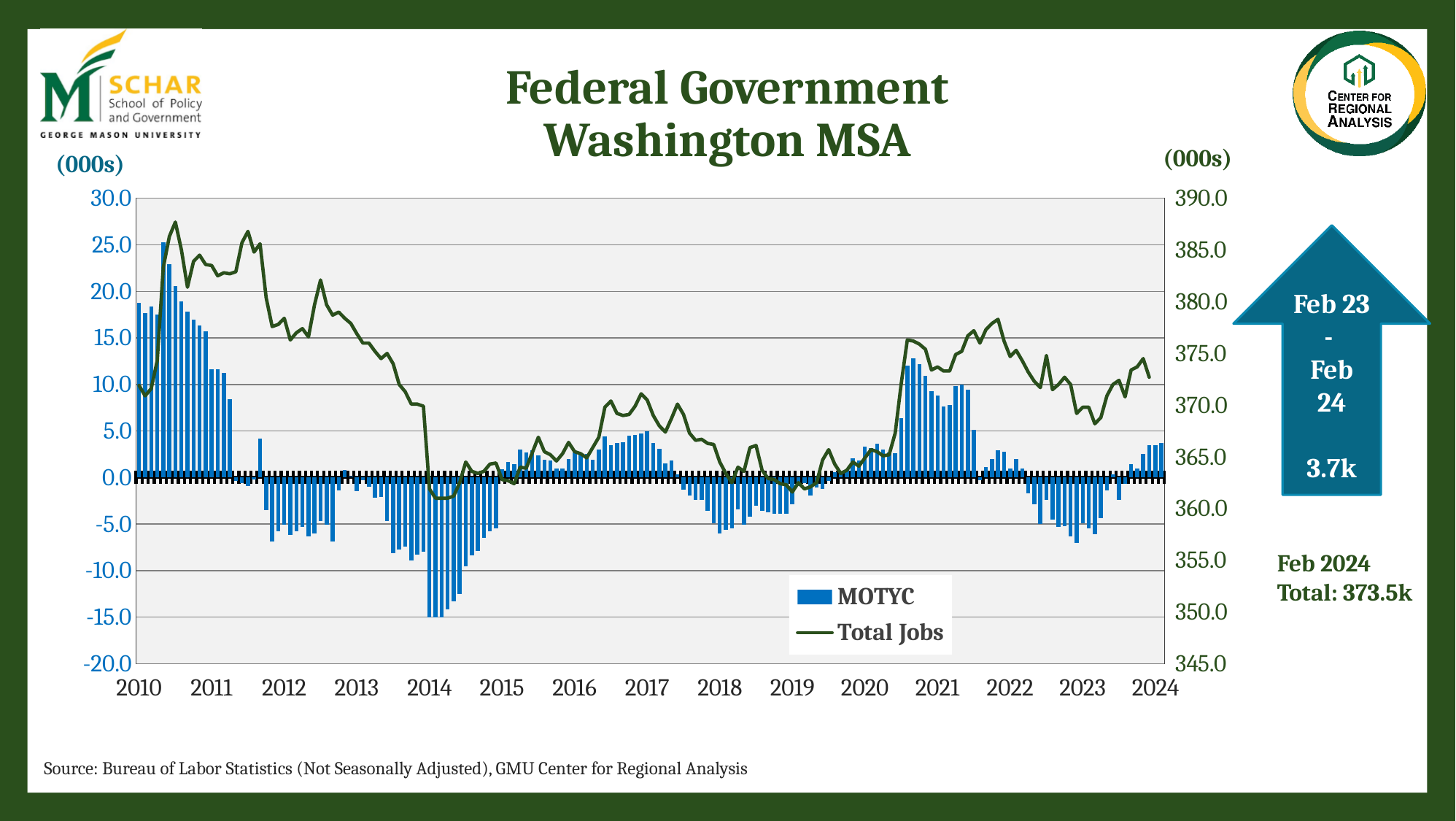
Does the Total Jobs line rise or fall between 2011 and 2014? fall Is the highest MOTYC bar in 2010 greater or less than 20.0? greater How many series does the legend list? 2 What kind of chart is this? Combination bar and line chart What is the Feb 2024 total for Federal Government jobs in the Washington MSA, as stated on the slide? 373.5k In which year does the MOTYC series reach its lowest bar? 2014 Is the Total Jobs line at the start of 2014 greater or less than 370.0? less Is the lowest MOTYC bar in 2014 greater or less than -10.0? less Which is higher, the Total Jobs line in 2011 or in 2023? 2011 What is the change in jobs from Feb 23 to Feb 24 shown in the arrow? 3.7k What are the two series named in the legend? MOTYC and Total Jobs What is the title of the chart? Federal Government Washington MSA